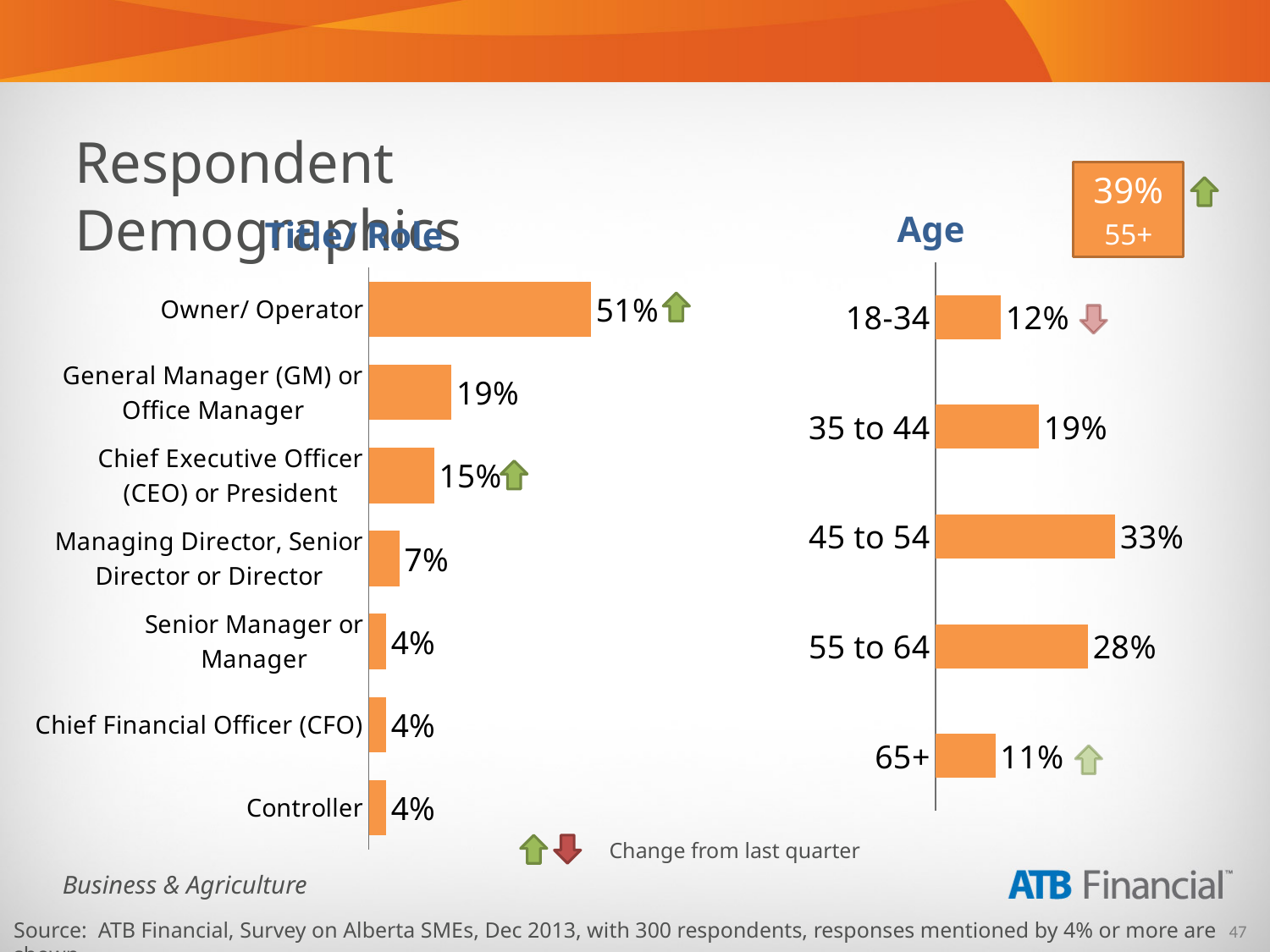
In the Title/Role chart, which is larger: Managing Director, Senior Director or Director, or Controller? Managing Director, Senior Director or Director In the Age chart, what is the value for 45 to 54? 33% In the Age chart, what is the value for 65+? 11% In the Age chart, which age group has the lowest value? 65+ In the Age chart, what is the difference between 45 to 54 and 55 to 64? 5% In the Title/Role chart, which category has the highest value? Owner/ Operator What kind of chart is the Age chart? Bar chart In the Title/Role chart, what is the difference between Owner/ Operator and General Manager (GM) or Office Manager? 32% In the Title/Role chart, what percentage of respondents are Owner/ Operator? 51% In the Title/Role chart, what is the value for Chief Executive Officer (CEO) or President? 15% In the Title/Role chart, how many categories are shown? 7 In the Age chart, how many age groups are shown? 5